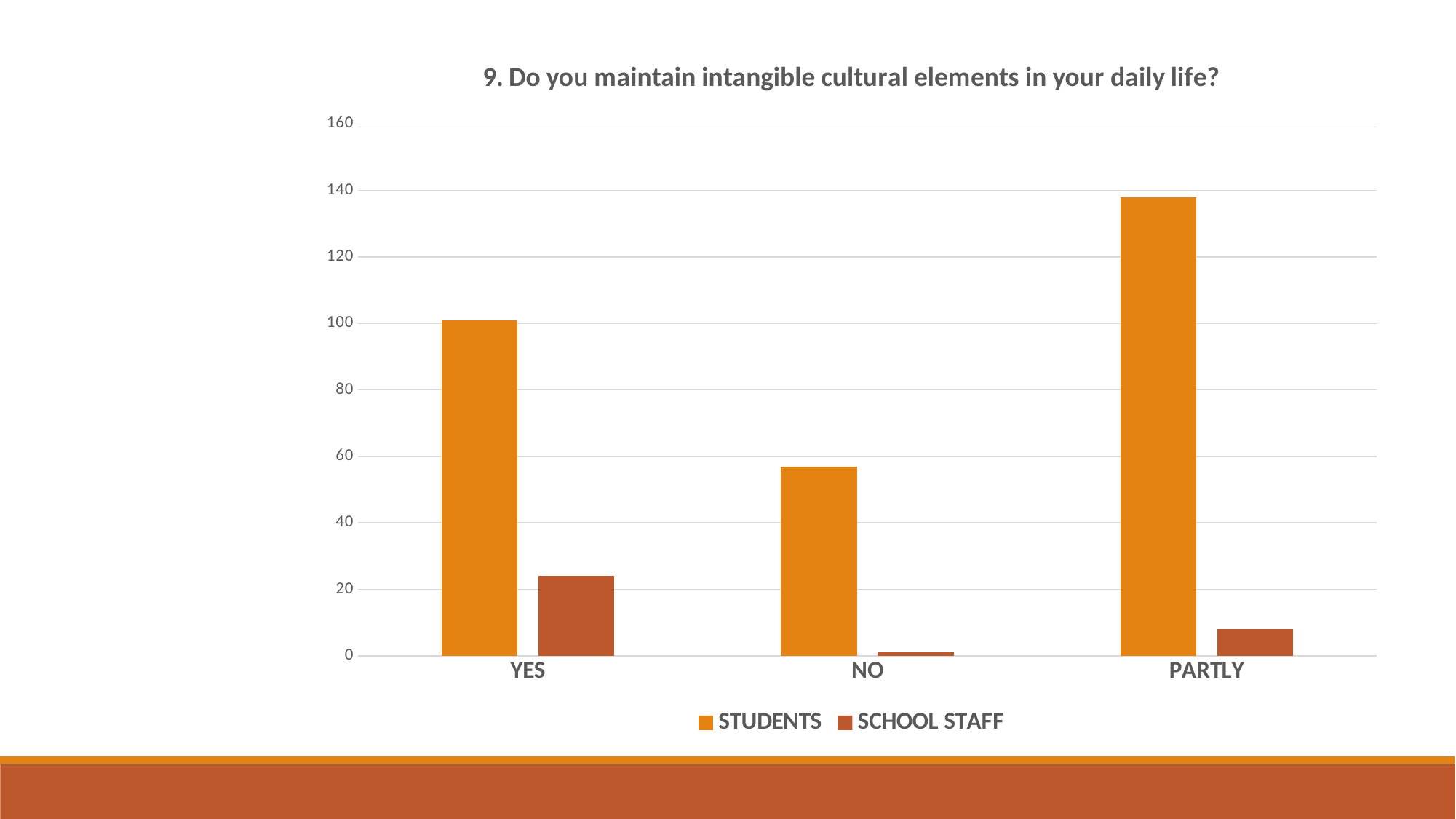
Is the STUDENTS value for PARTLY greater or less than 120? greater Which category has the highest value for STUDENTS? PARTLY What is the title of the chart? 9. Do you maintain intangible cultural elements in your daily life? Which category has the lowest value for SCHOOL STAFF? NO What type of chart is shown on the slide? bar chart Which is larger: the STUDENTS value for YES or the STUDENTS value for NO? YES How many categories are shown on the x axis? 3 Is the STUDENTS value for NO greater or less than 80? less Which category has the lowest value for STUDENTS? NO Which category has the highest value for SCHOOL STAFF? YES How many series does the legend list? 2 Is the SCHOOL STAFF value for PARTLY greater or less than 20? less